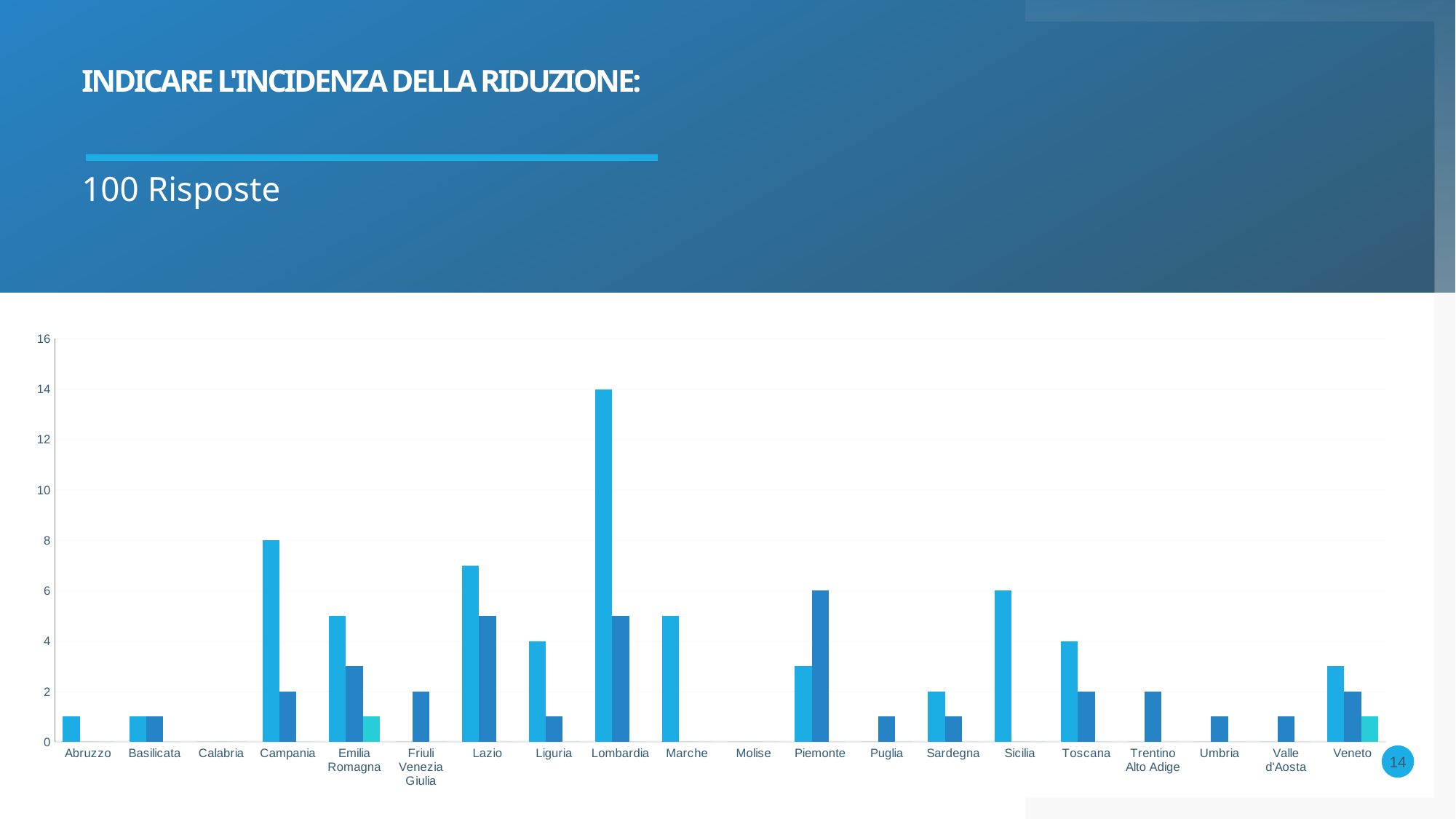
What is the value of the light blue bar for Lombardia? 14 What kind of chart is shown on the slide? bar chart What is the value of the light blue bar for Sicilia? 6 What is the value of the light blue bar for Campania? 8 What is the difference between the light blue bars for Lombardia and Campania? 6 What is the highest value shown on the vertical axis of the chart? 16 How many regions are listed along the x axis of the chart? 20 What is the value of the light blue bar for Toscana? 4 Is the light blue bar for Lazio greater or less than 6? greater What is the value of the dark blue bar for Piemonte? 6 Which is larger, the light blue bar for Campania or the light blue bar for Sicilia? Campania Which region has the tallest bar in the chart? Lombardia